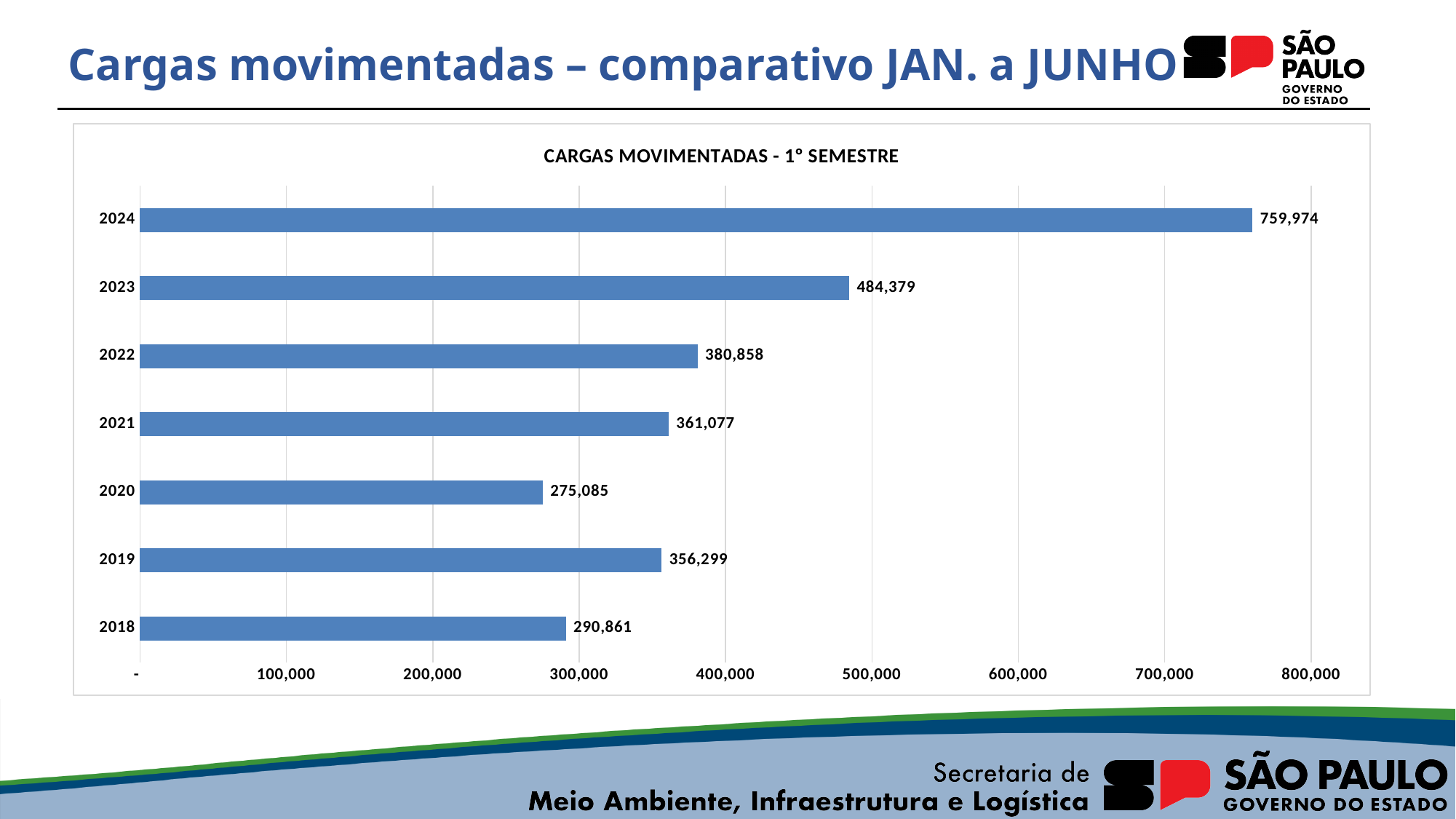
Is the value for 2023 greater or less than 500,000? less What is the value for 2024 in the chart? 759,974 How many years are shown in the chart? 7 Which is larger, the value for 2022 or the value for 2019? 2022 What is the difference between the values for 2019 and 2018? 65,438 What is the title of the chart? CARGAS MOVIMENTADAS - 1° SEMESTRE What kind of chart is shown on the slide? bar chart Which year has the lowest value in the chart? 2020 What is the difference between the values for 2024 and 2023? 275,595 What is the value for 2020 in the chart? 275,085 Which year has the highest value in the chart? 2024 What is the value for 2018 in the chart? 290,861